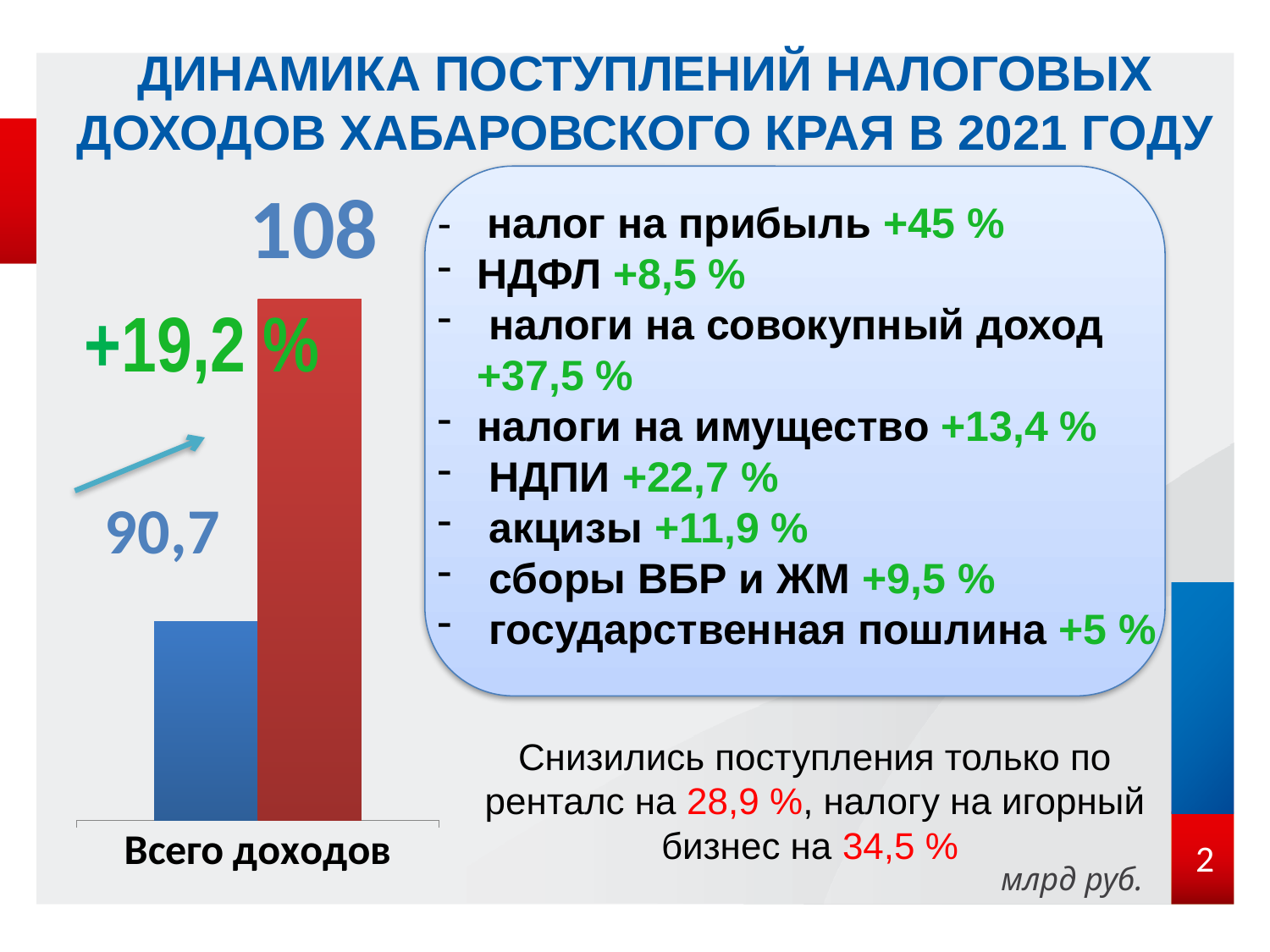
What is the category label under the bars? Всего доходов Do the values rise or fall from the blue bar to the red bar? rise What is the lowest value plotted in the chart? 90,7 How many categories are shown on the x axis of the chart? 1 What is the value shown above the red bar? 108 What percentage change is written next to the arrow between the two bars? +19,2 % What is the highest value plotted in the chart? 108 What is the value shown above the blue bar? 90,7 What kind of chart is shown on the slide? bar chart What is the difference between the red bar value (108) and the blue bar value (90,7)? 17,3 Which bar is taller, the blue bar or the red bar? the red bar